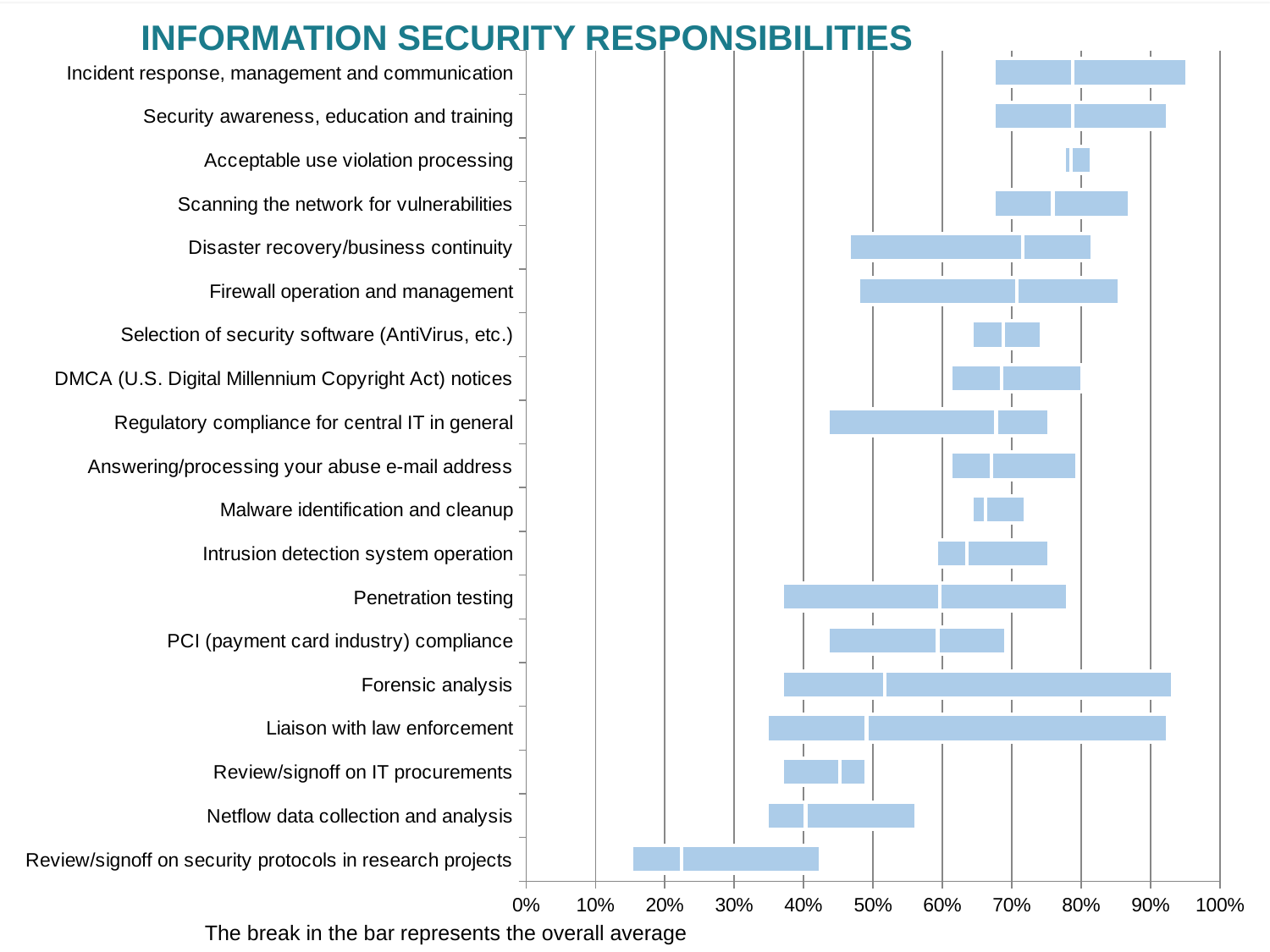
Is the overall average for Disaster recovery/business continuity greater or less than 60%? greater Is the overall average for Incident response, management and communication greater or less than 70%? greater According to the note below the chart, what does the break in each bar represent? The overall average Which has a higher overall average: Incident response, management and communication or Netflow data collection and analysis? Incident response, management and communication Which category has the lowest overall average? Review/signoff on security protocols in research projects Is the overall average for Review/signoff on security protocols in research projects greater or less than 30%? less What is the title of the chart? INFORMATION SECURITY RESPONSIBILITIES What kind of chart is shown on the slide? bar chart How many responsibility categories are listed on the chart? 19 Which category's bar extends furthest to the left on the axis? Review/signoff on security protocols in research projects